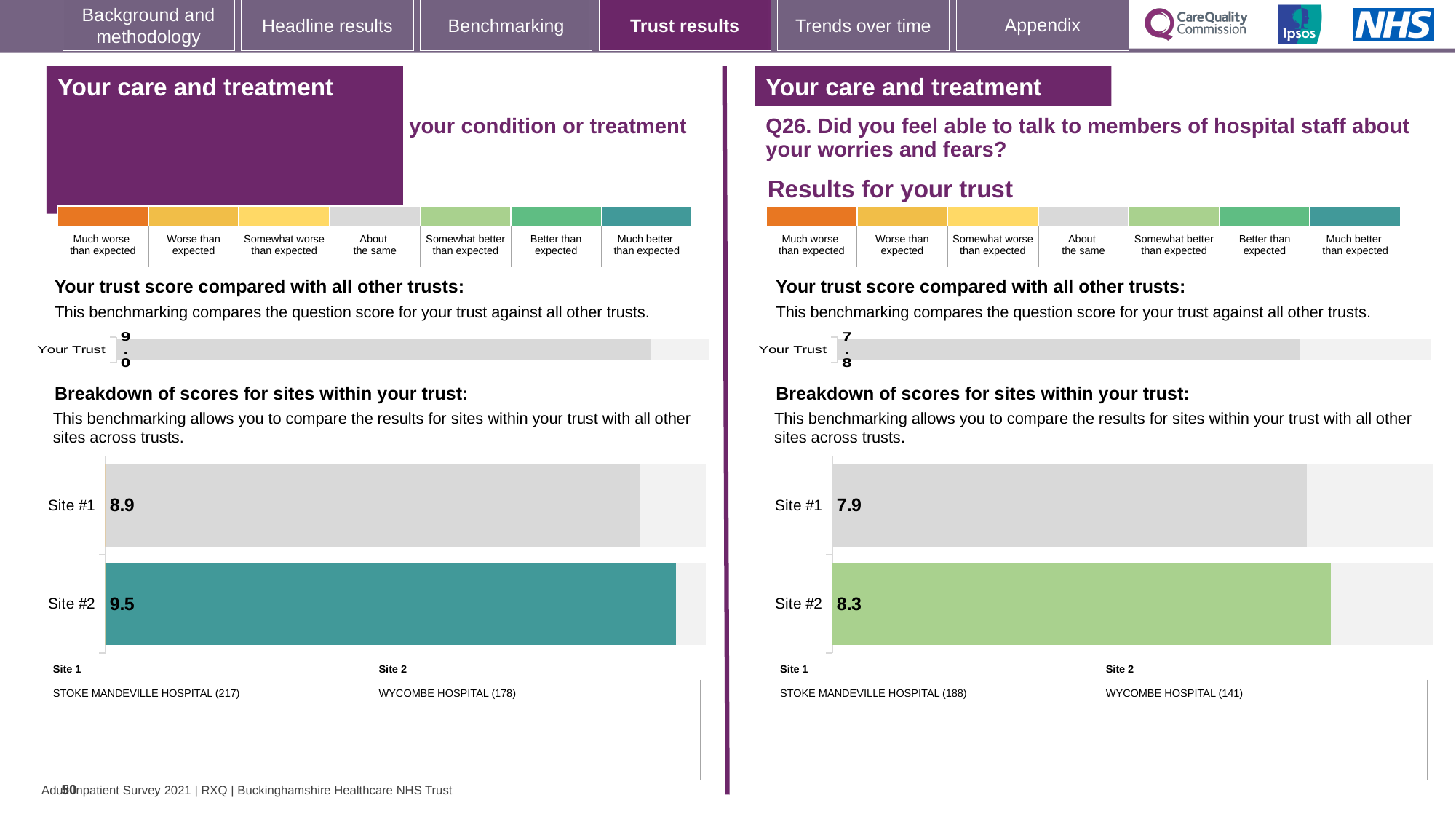
On the left-hand panel's site breakdown chart, what is the difference between the Site #2 and Site #1 scores? 0.6 On the left-hand panel's site breakdown chart, what is the score for Site #1? 8.9 On the right-hand panel (Q26) 'Your Trust' chart, what is the trust score shown? 7.8 What type of chart is used for the site breakdown on the left-hand panel? Bar chart On the right-hand panel (Q26) site breakdown chart, what is the difference between the Site #2 and Site #1 scores? 0.4 On the left-hand panel's site breakdown chart, which site has the higher score? Site #2 On the right-hand panel (Q26) site breakdown chart, what is the score for Site #2? 8.3 How many sites are shown in the right-hand panel (Q26) site breakdown chart? 2 On the right-hand panel (Q26) site breakdown chart, which site has the lower score? Site #1 On the left-hand panel's 'Your Trust' chart, what is the trust score shown? 9.0 On the right-hand panel (Q26) site breakdown chart, what is the score for Site #1? 7.9 On the left-hand panel's site breakdown chart, what is the score for Site #2? 9.5